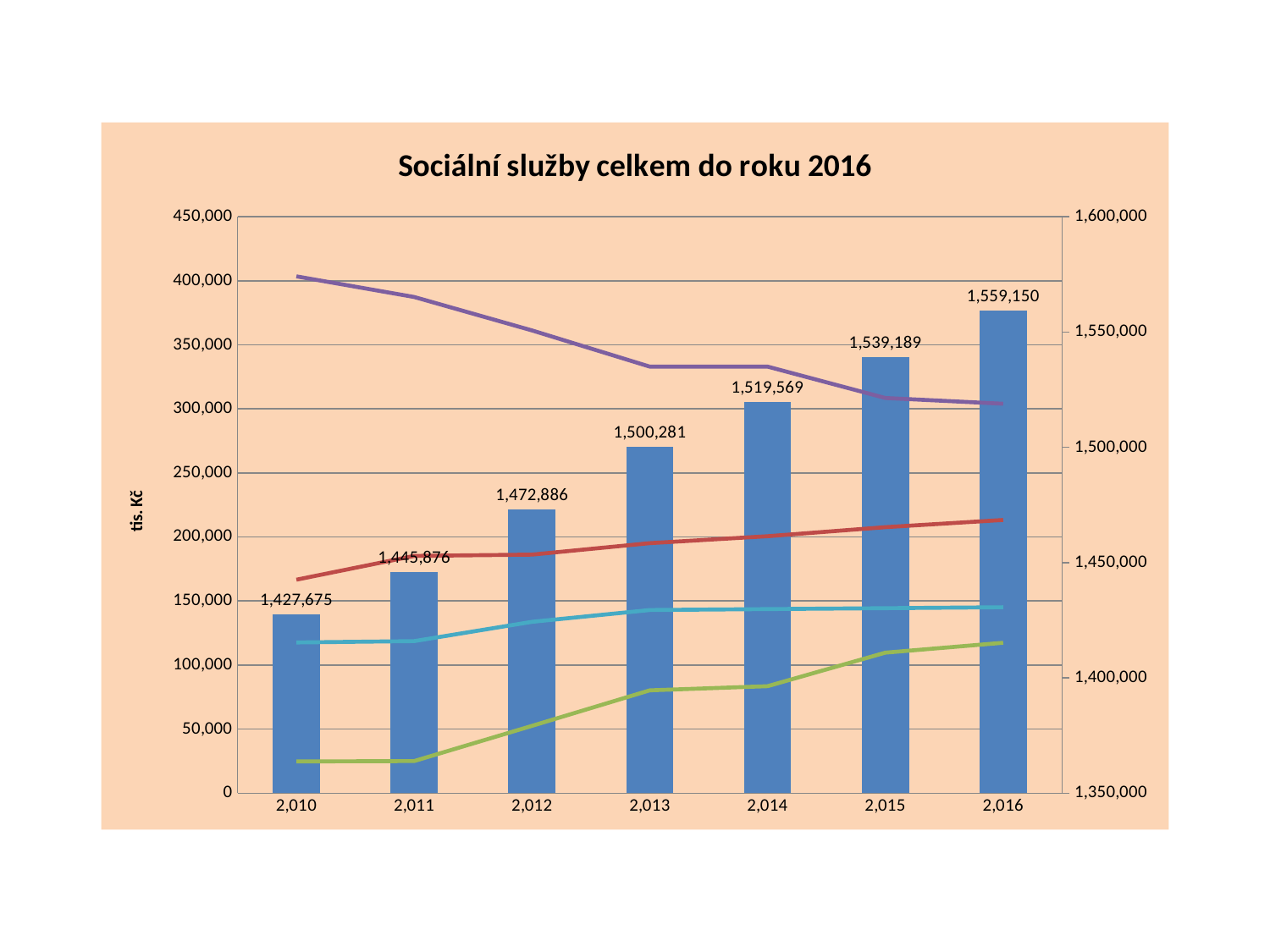
Do the bar values rise or fall from 2,010 to 2,016? rise How many bars are plotted in the chart? 7 What is the difference between the bar values for 2,016 and 2,010? 131,475 Which year has the highest bar value? 2,016 Which year has the lowest bar value? 2,010 Is the value of the green line at 2,010 on the left axis greater or less than 50,000? less What is the difference between the bar values for 2,015 and 2,014? 19,620 Does the purple line rise or fall from 2,010 to 2,016? fall What is the value shown on the bar for 2,016? 1,559,150 What is the value shown on the bar for 2,010? 1,427,675 What is the title of the chart? Sociální služby celkem do roku 2016 What is the value shown on the bar for 2,013? 1,500,281